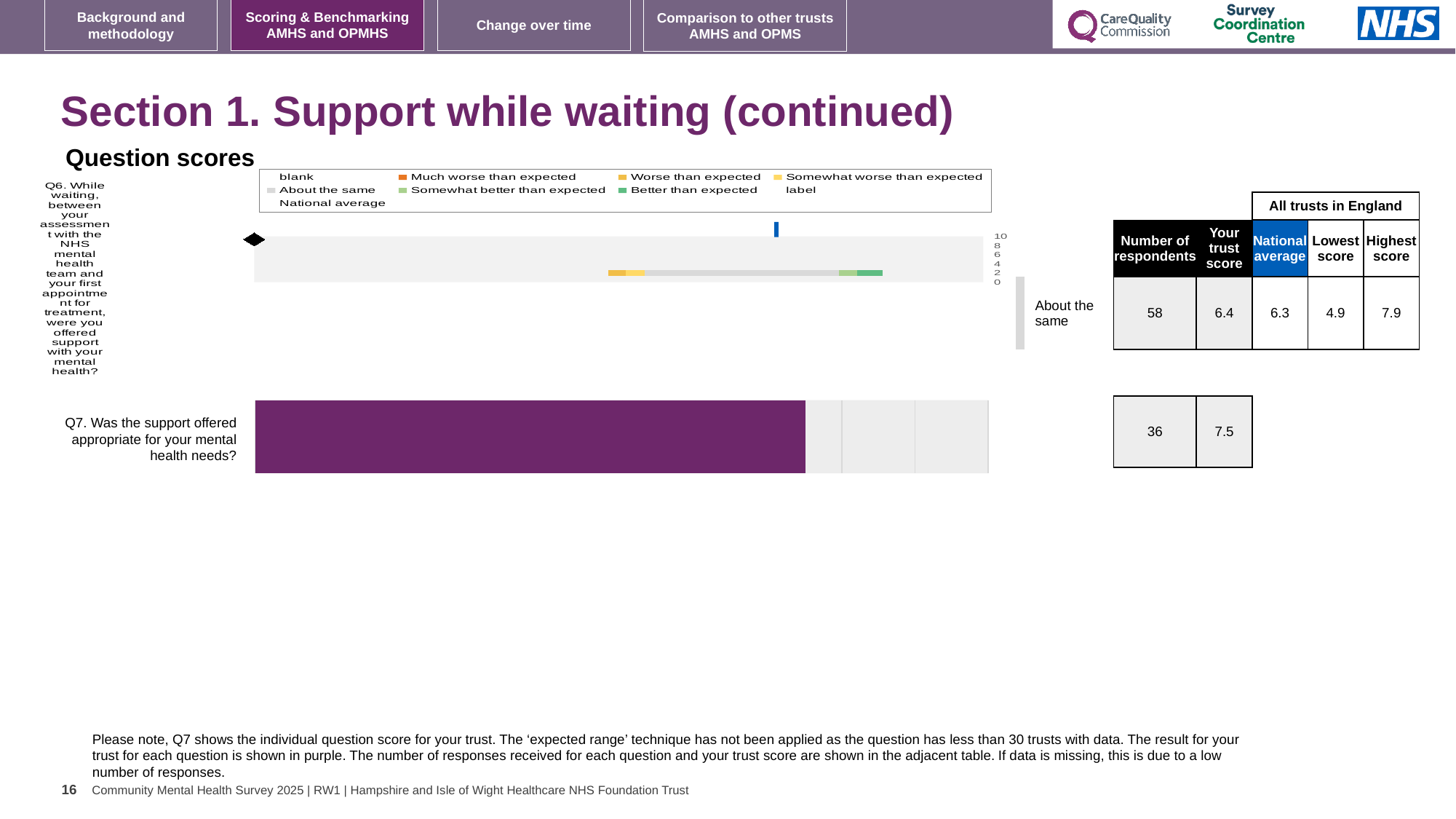
How many respondents answered Q6? 58 What is the national average score for Q6? 6.3 What is the lowest score among all trusts in England for Q6? 4.9 For Q6, which is larger: the trust score or the national average? The trust score (6.4) What category label is shown for the trust's Q6 result relative to the expected range? About the same What is the 'Your trust score' for Q6 (support while waiting between assessment and first appointment)? 6.4 What colour is the Q7 bar on the chart? Purple How many respondents answered Q7? 36 Is the Q7 bar greater or less than 6 on the 0–10 axis? greater What is the difference between the highest and lowest scores for Q6 across all trusts in England? 3.0 What is the highest score among all trusts in England for Q6? 7.9 What is the trust score for Q7 (Was the support offered appropriate for your mental health needs)? 7.5